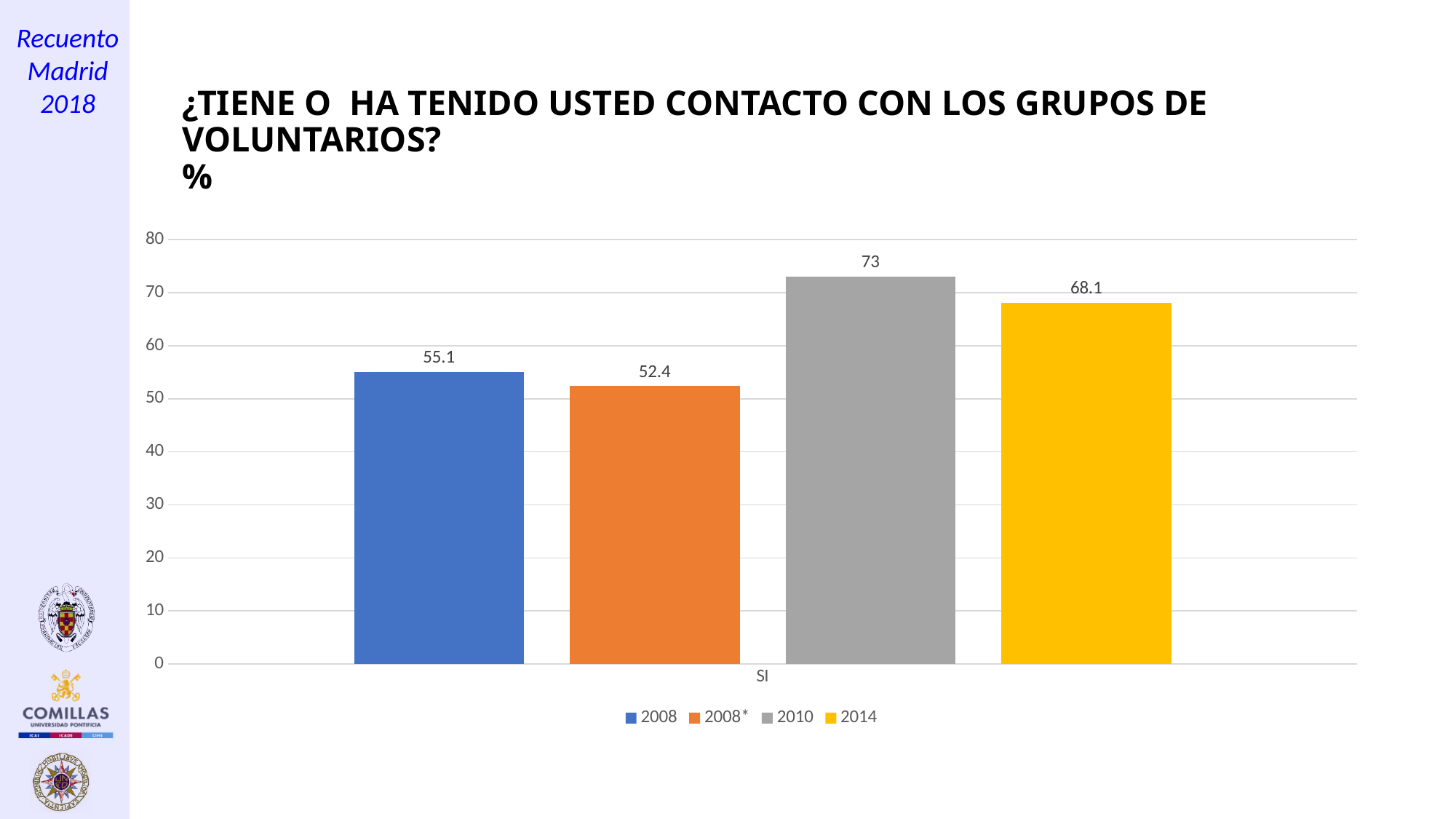
What is the difference between the 2010 value and the 2014 value? 4.9 Which is larger, the value for 2008 or the value for 2008*? 2008 Is the value for 2014 greater or less than 60? greater What is the category label shown on the x axis? SI Which series has the highest value? 2010 Which series has the lowest value? 2008* What is the value for the 2008 series? 55.1 What kind of chart is shown on the slide? bar chart What is the value for the 2008* series? 52.4 What is the value for the 2014 series? 68.1 What is the value for the 2010 series? 73 How many series does the legend list? 4